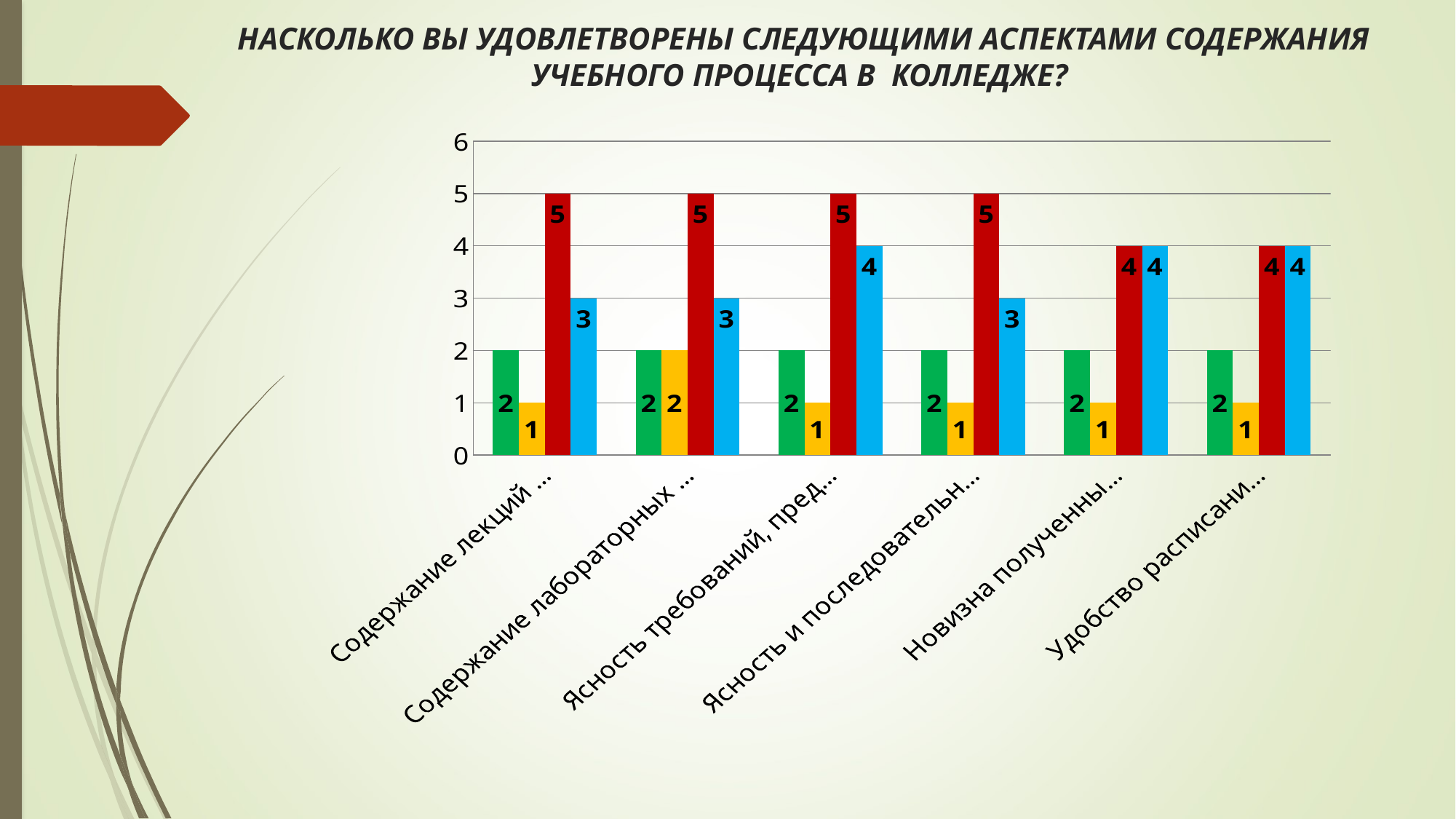
What is the value of the yellow bar for the category "Содержание лабораторных"? 2 Which is larger for the category "Ясность требований": the green bar or the blue bar? the blue bar Which bar has the highest value in the category "Ясность и последовательн"? the red bar (5) Which bar has the lowest value in the category "Новизна полученны"? the yellow bar (1) What type of chart is shown on the slide? bar chart What is the value of the red bar for the category "Содержание лекций"? 5 What is the difference between the red bar and the blue bar for the category "Содержание лекций"? 2 What is the value of the green bar for the category "Удобство расписани"? 2 How many categories are shown on the x axis of the chart? 6 What is the title of the chart on the slide? НАСКОЛЬКО ВЫ УДОВЛЕТВОРЕНЫ СЛЕДУЮЩИМИ АСПЕКТАМИ СОДЕРЖАНИЯ УЧЕБНОГО ПРОЦЕССА В КОЛЛЕДЖЕ? What is the value of the blue bar for the category "Ясность требований"? 4 How many bars are plotted for each category in the chart? 4